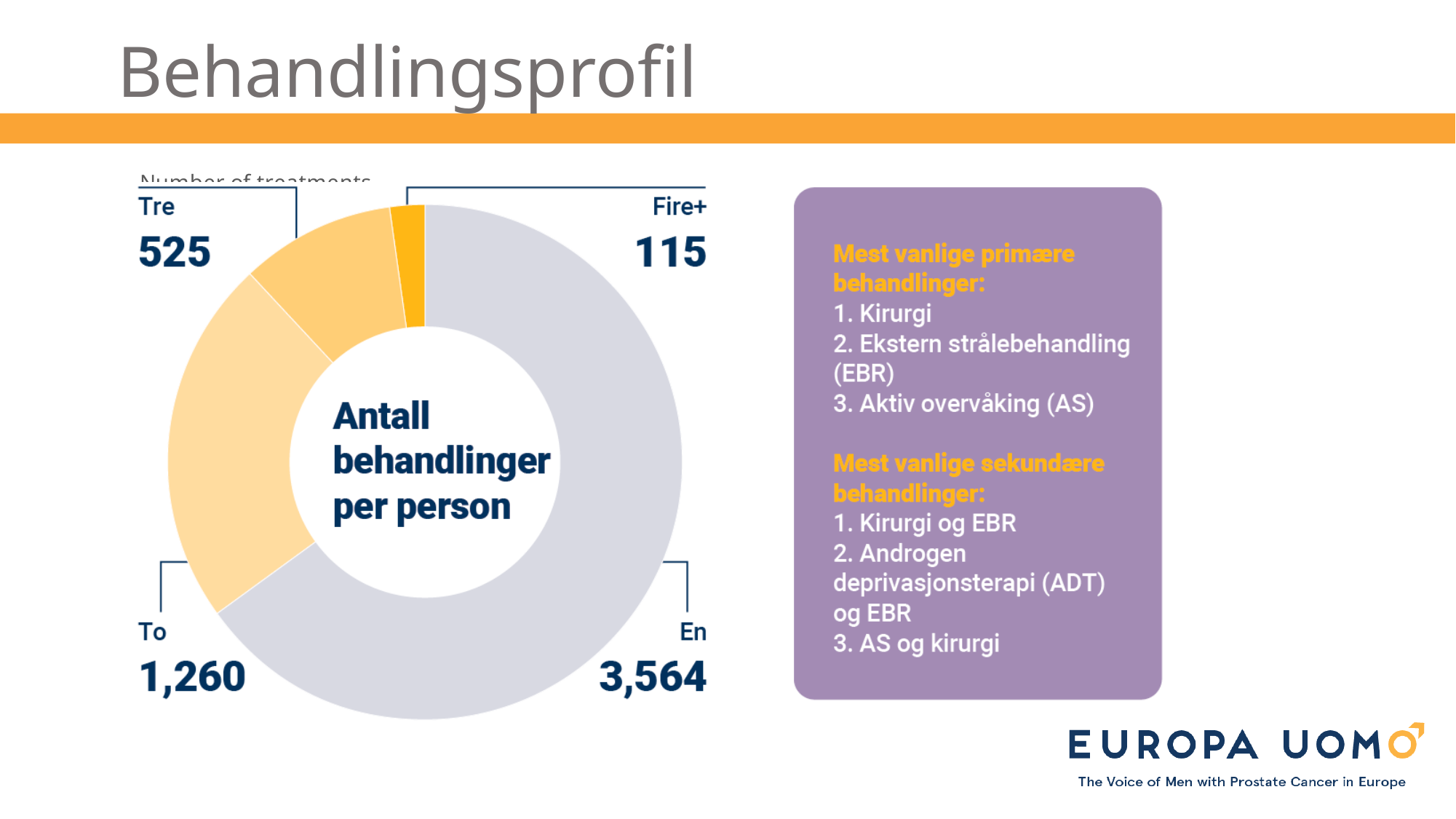
What is the difference between the values for "En" and "To"? 2,304 How many categories does the donut chart show? 4 What is the difference between the values for "Tre" and "Fire+"? 410 What is the value for the "Fire+" segment of the donut chart? 115 Which category has the smallest value in the donut chart? Fire+ What is the value for the "Tre" segment of the donut chart? 525 Which category has the largest value in the donut chart? En What text is written in the centre of the donut chart? Antall behandlinger per person What kind of chart is shown on the slide? Donut (pie) chart What is the value for the "To" segment of the donut chart? 1,260 What is the value for the "En" segment of the donut chart? 3,564 Which is larger, the value for "To" or the value for "Tre"? To